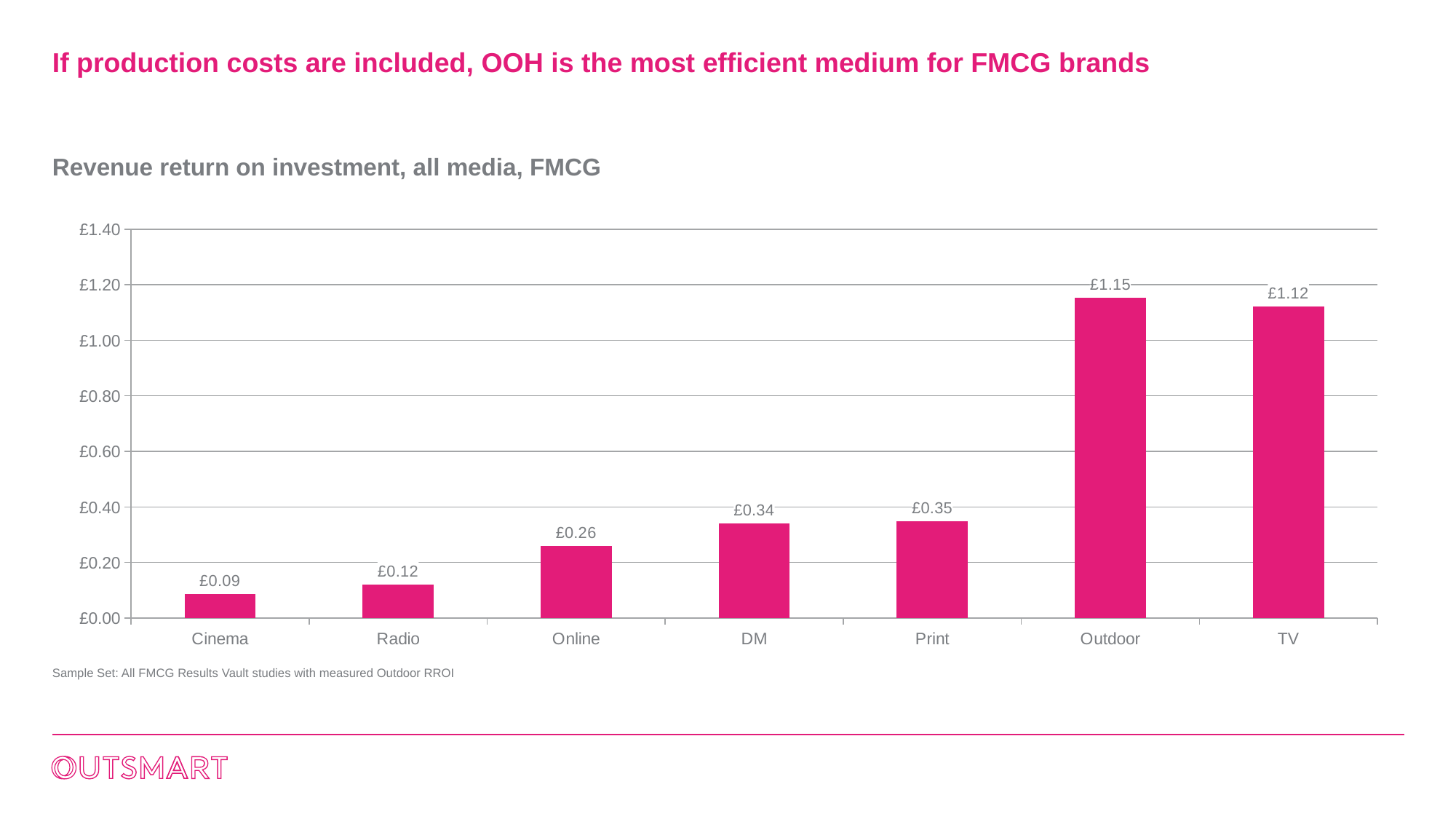
Which medium has the highest revenue return on investment? Outdoor What is the revenue return on investment for Outdoor? £1.15 What is the difference between the values for Outdoor and TV? £0.03 What kind of chart is shown on the slide? Bar chart Which has a higher value, DM or Online? DM What is the revenue return on investment for Cinema? £0.09 What is the title of the chart? Revenue return on investment, all media, FMCG What is the difference between the values for Print and Radio? £0.23 Which medium has the lowest revenue return on investment? Cinema Is the value for TV greater or less than £1.00? greater How many media categories are shown on the x axis? 7 What is the value shown for Online? £0.26